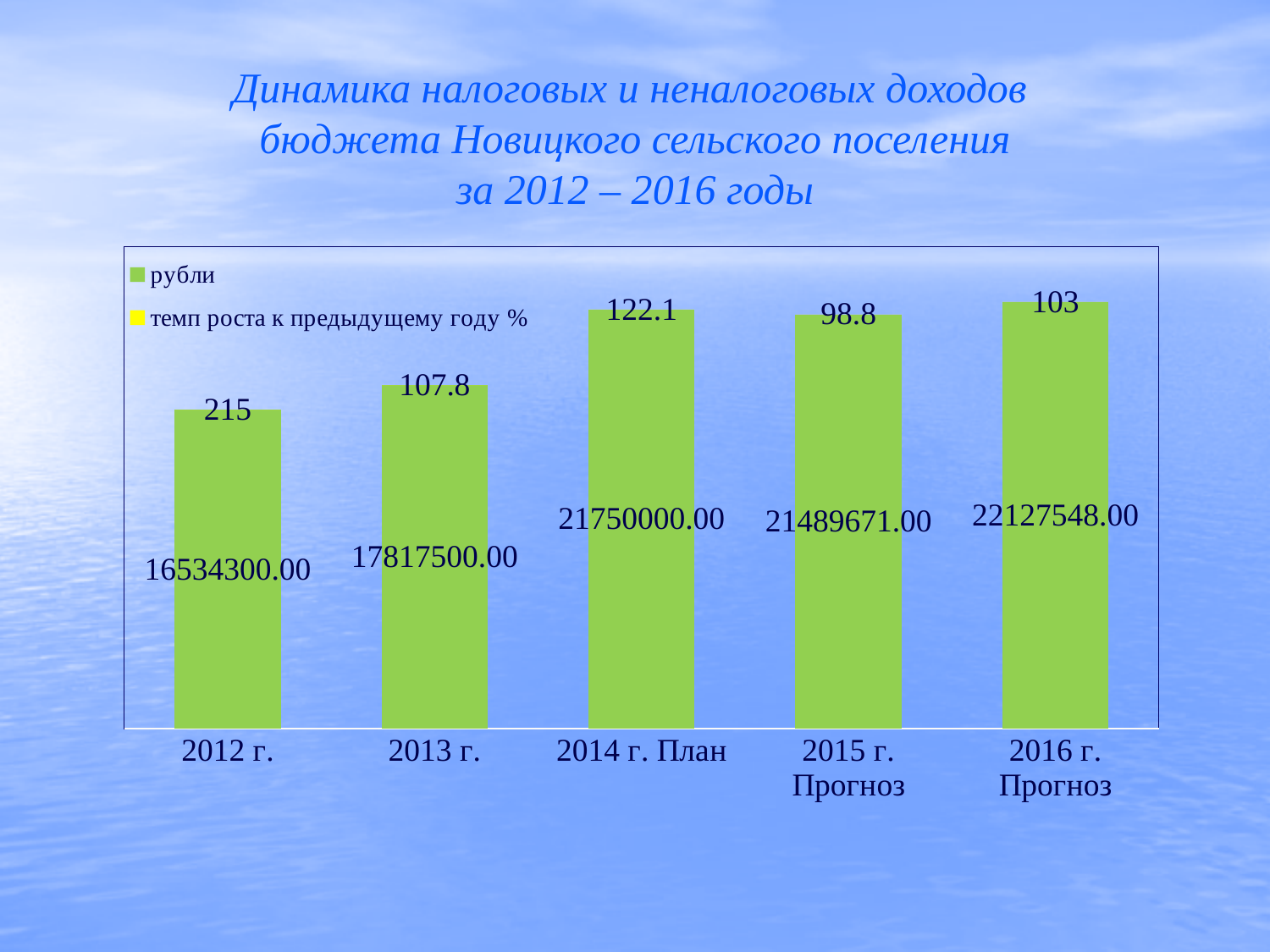
How many series does the chart legend list? 2 What type of chart is shown on the slide? bar chart Which year has the lowest рубли value? 2012 г. Which is larger, the рубли value for 2014 г. План or for 2015 г. Прогноз? 2014 г. План What is the difference in рубли between 2014 г. План and 2013 г.? 3932500.00 Which year has the highest рубли value? 2016 г. Прогноз What is the value of рубли for 2012 г.? 16534300.00 What is the темп роста к предыдущему году % value for 2013 г.? 107.8 What is the value of рубли for 2014 г. План? 21750000.00 Which year has the highest темп роста к предыдущему году % value? 2012 г. What is the темп роста к предыдущему году % value for 2015 г. Прогноз? 98.8 How many categories (years) are shown on the x axis of the chart? 5